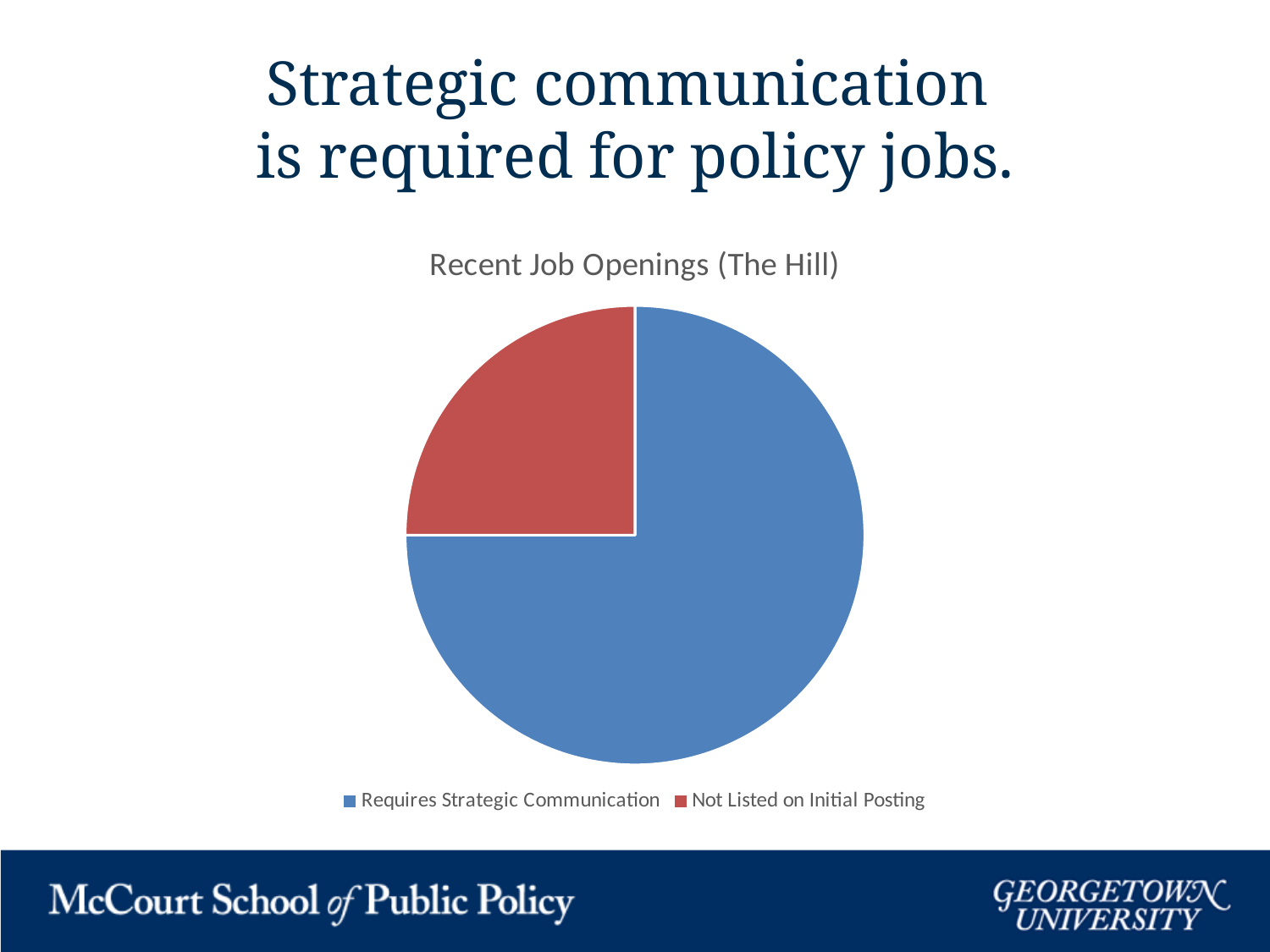
How many entries does the legend list? 2 What colour is the slice for Not Listed on Initial Posting? red Which category has the largest slice of the pie? Requires Strategic Communication What kind of chart is shown on the slide? pie chart Which category has the smallest slice of the pie? Not Listed on Initial Posting How many slices does the pie chart have? 2 Which slice is larger: Requires Strategic Communication or Not Listed on Initial Posting? Requires Strategic Communication What is the title of the chart? Recent Job Openings (The Hill)